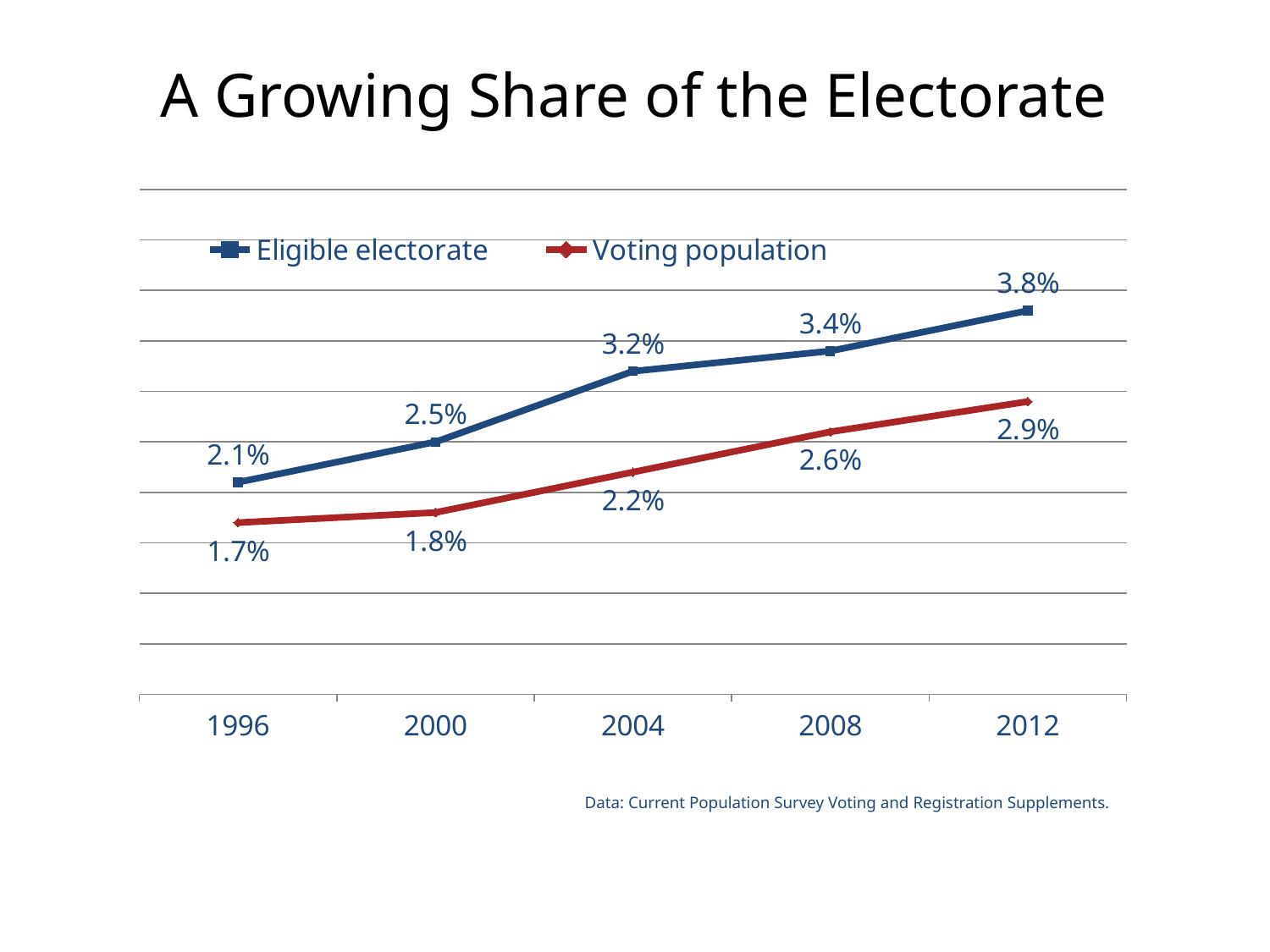
What is the Voting population value for 2008? 2.6% By how much did the Voting population value change from 1996 to 2012? 1.2% Do the Eligible electorate values rise or fall from 1996 to 2012? Rise Which is larger in 2000: the Eligible electorate or the Voting population? Eligible electorate In which year is the Eligible electorate lowest? 1996 How many series does the legend list? 2 What is the Eligible electorate value for 2004? 3.2% What is the difference between the Eligible electorate and Voting population values in 2012? 0.9% In which year is the Voting population highest? 2012 How many years are shown on the x axis? 5 What kind of chart is shown on the slide? Line chart What is the Eligible electorate value for 1996? 2.1%